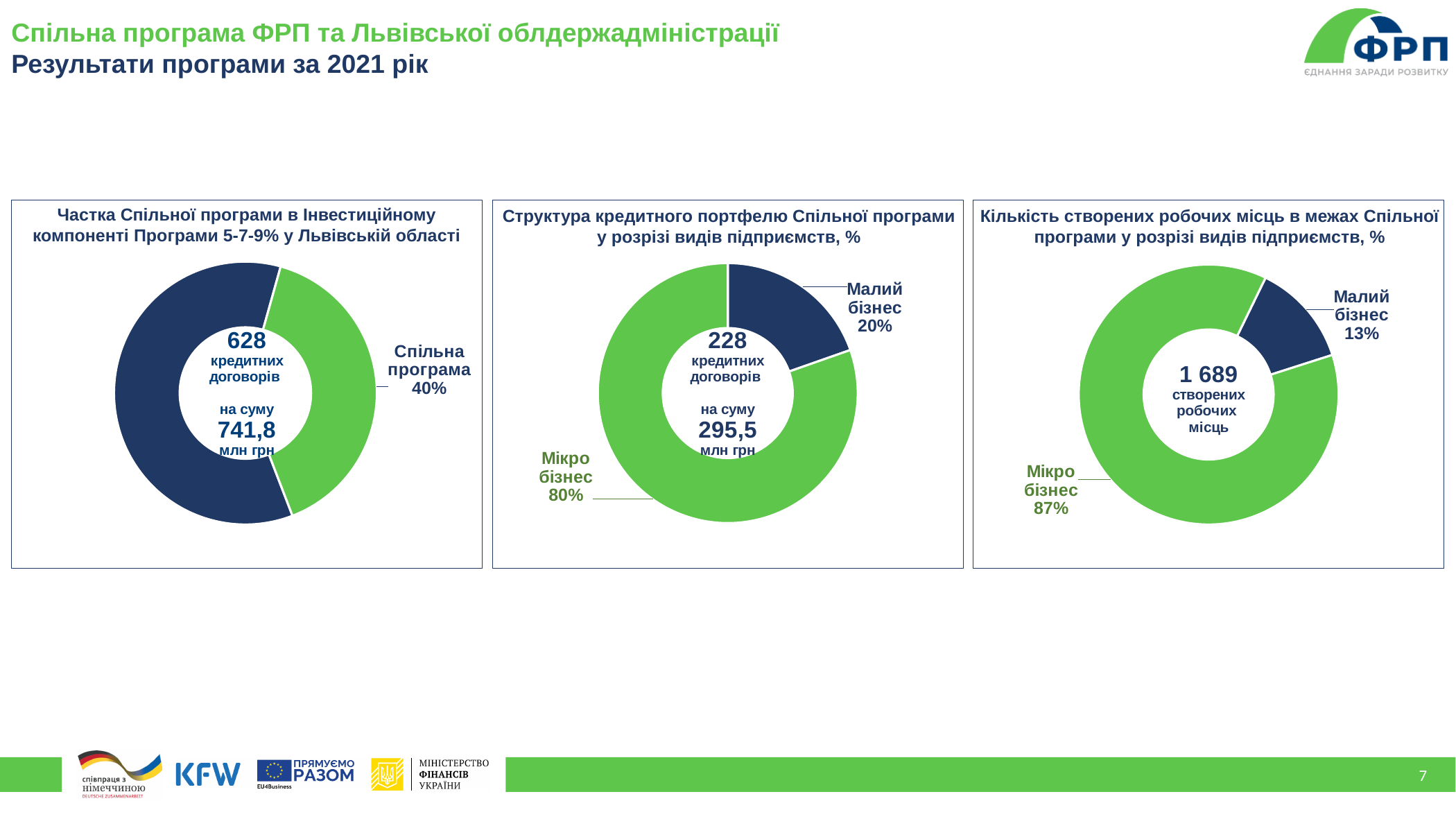
In the middle chart, how many кредитних договорів are shown in the centre of the donut? 228 In the middle chart, by how many percentage points does Мікро бізнес exceed Малий бізнес? 60 In the right chart (Кількість створених робочих місць в межах Спільної програми у розрізі видів підприємств, %), what share is labelled for Малий бізнес? 13% In the middle chart (Структура кредитного портфелю Спільної програми у розрізі видів підприємств, %), what share is labelled for Малий бізнес? 20% In the right chart, which colour represents Мікро бізнес? Green In the middle chart, what share is labelled for Мікро бізнес? 80% What type of chart is used in the middle panel of the slide? Donut (pie) chart In the right chart, which category has the largest share? Мікро бізнес In the right chart, how many створених робочих місць are shown in the centre of the donut? 1 689 In the left chart (Частка Спільної програми в Інвестиційному компоненті Програми 5-7-9% у Львівській області), what share is labelled for Спільна програма? 40% In the left chart, how many кредитних договорів are shown in the centre of the donut? 628 In the left chart, what total amount (на суму) is shown in the centre of the donut? 741,8 млн грн